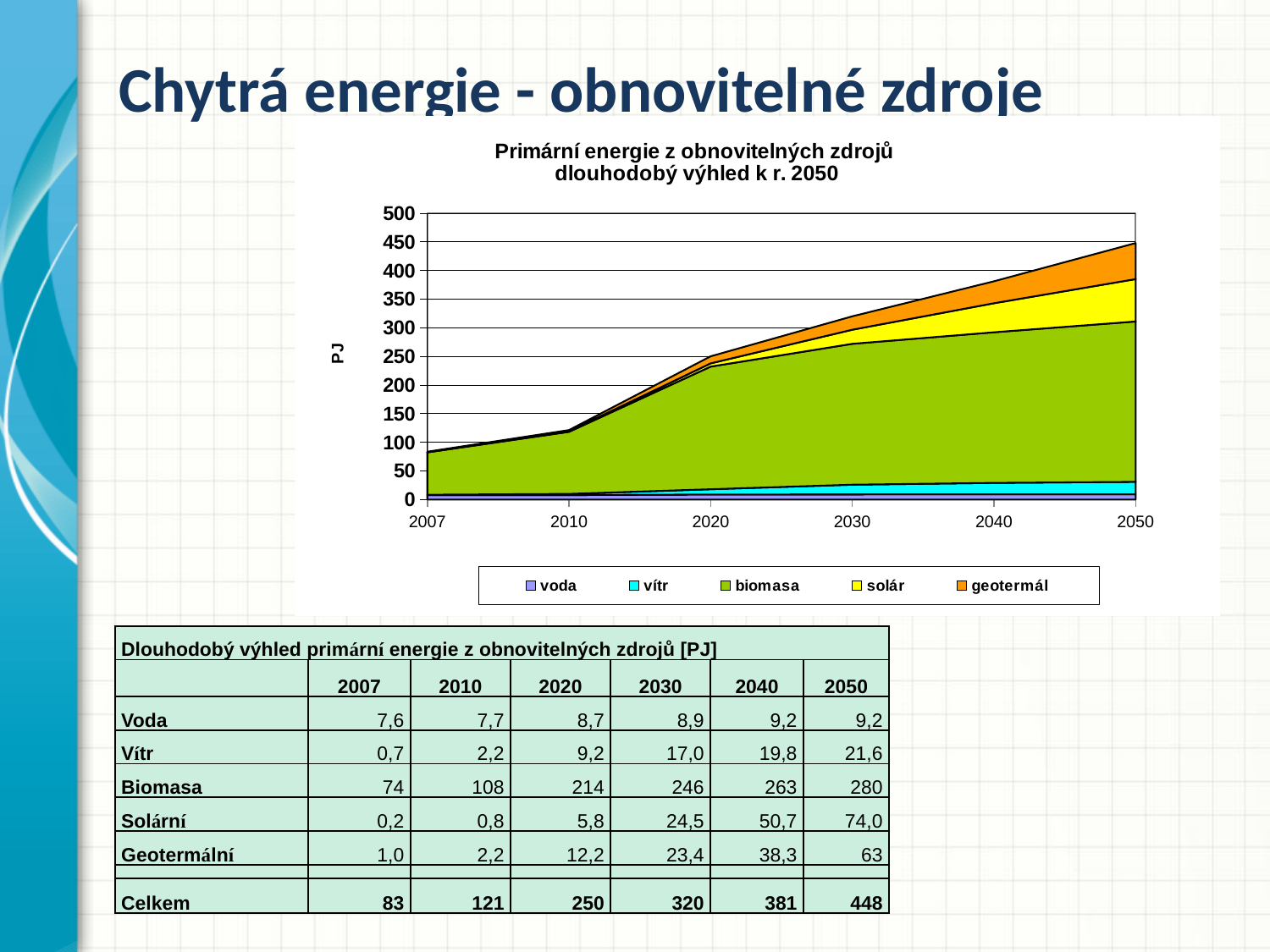
Is the total value for 2030 greater or less than 300? greater Which is larger in 2050, the value for solár or the value for geotermál? solár What is the difference between the total in 2050 and the total in 2007, in PJ? 365 How many years are plotted along the x axis of the chart? 6 How many series does the chart legend list? 5 What is the total primary energy from renewable sources in 2050, in PJ? 448 What is the value for solár in 2040? 50,7 Which series has the lowest value in 2007? solár What is the value for biomasa in 2050? 280 Does the total primary energy from renewable sources rise or fall from 2007 to 2050? rises What kind of chart is shown on the slide? stacked area chart Which series has the highest value in 2050? biomasa